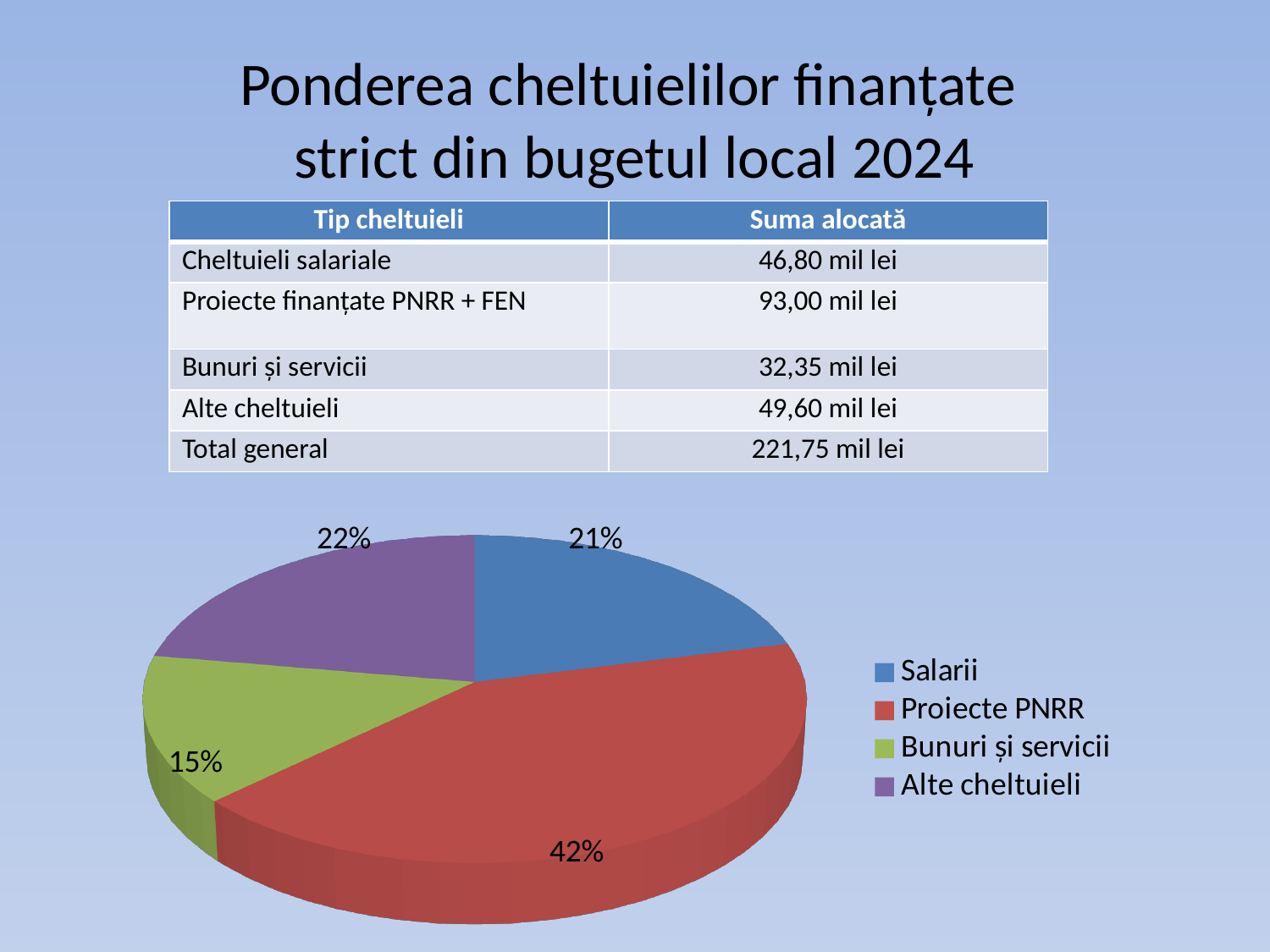
What share of the pie does Salarii represent? 21% Which category has the smallest slice of the pie? Bunuri și servicii What share of the pie does Proiecte PNRR represent? 42% What colour is the Proiecte PNRR slice in the pie chart? Red How many slices does the pie chart have? 4 What share of the pie does Bunuri și servicii represent? 15% Which category has the largest slice of the pie? Proiecte PNRR How many entries does the legend list? 4 What type of chart is shown on the slide? Pie chart What is the difference in percentage points between the Proiecte PNRR slice and the Salarii slice? 21 Which slice is larger, Alte cheltuieli or Bunuri și servicii? Alte cheltuieli